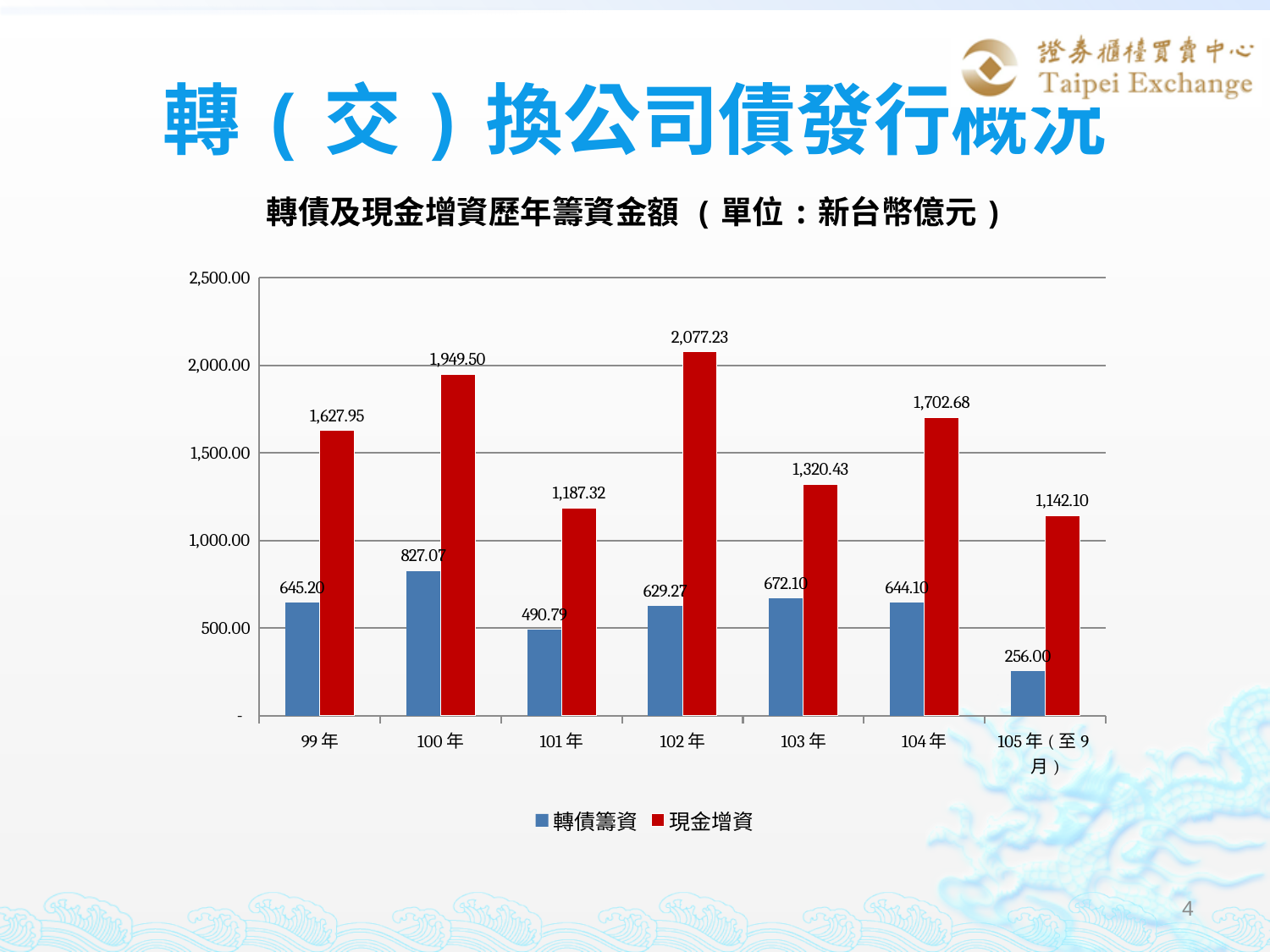
How many series does the legend list? 2 Which year has the highest 現金增資 value? 102年 How many year categories are shown on the x axis? 7 What is the value of 轉債籌資 for 105年(至9月)? 256.00 What is the value of 現金增資 for 102年? 2,077.23 What is the value of 轉債籌資 for 100年? 827.07 Which year has the lowest 轉債籌資 value? 105年(至9月) Is the 現金增資 value for 101年 greater or less than 1,000.00? greater Is the 轉債籌資 value for 103年 larger than the 轉債籌資 value for 104年? Yes What kind of chart is shown on the slide? Bar chart What colour represents 現金增資 in the chart? Red What is the difference between 現金增資 and 轉債籌資 in 102年? 1,447.96